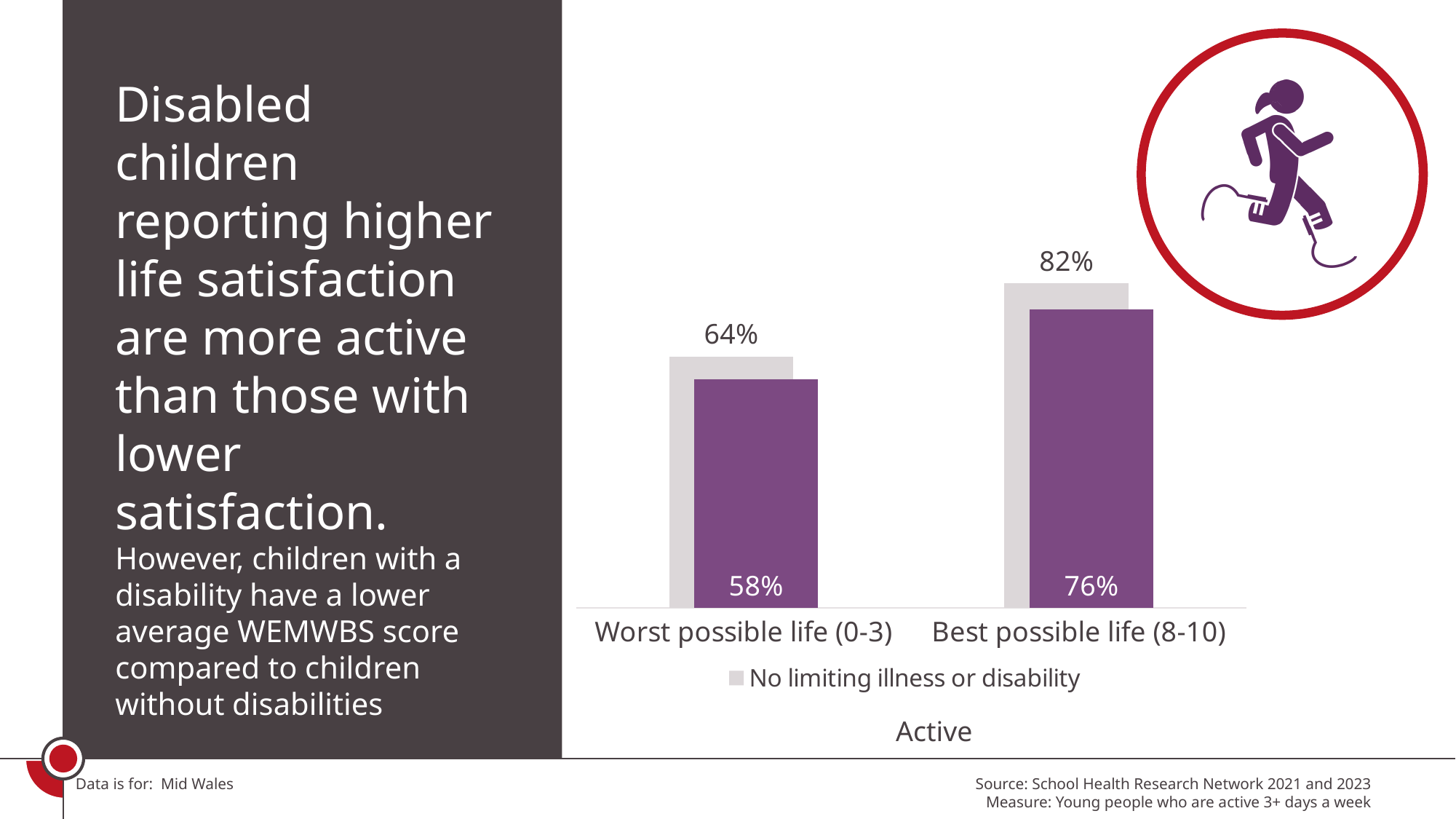
What is the value for 'No limiting illness or disability' in the 'Worst possible life (0-3)' category? 64% Which category has the lower value on the purple bars? Worst possible life (0-3) In the 'Worst possible life (0-3)' category, which is larger: the grey bar or the purple bar? The grey bar What kind of chart is shown on the slide? Bar chart What is the value for 'No limiting illness or disability' in the 'Best possible life (8-10)' category? 82% What value is printed on the purple bar for 'Worst possible life (0-3)'? 58% What is the title of the chart? Active Which category has the higher value for 'No limiting illness or disability'? Best possible life (8-10) What is the difference between the 'No limiting illness or disability' values for 'Best possible life (8-10)' and 'Worst possible life (0-3)'? 18% How many categories are shown on the x axis? 2 What value is printed on the purple bar for 'Best possible life (8-10)'? 76% In the 'Best possible life (8-10)' category, what is the difference between the grey bar and the purple bar? 6%